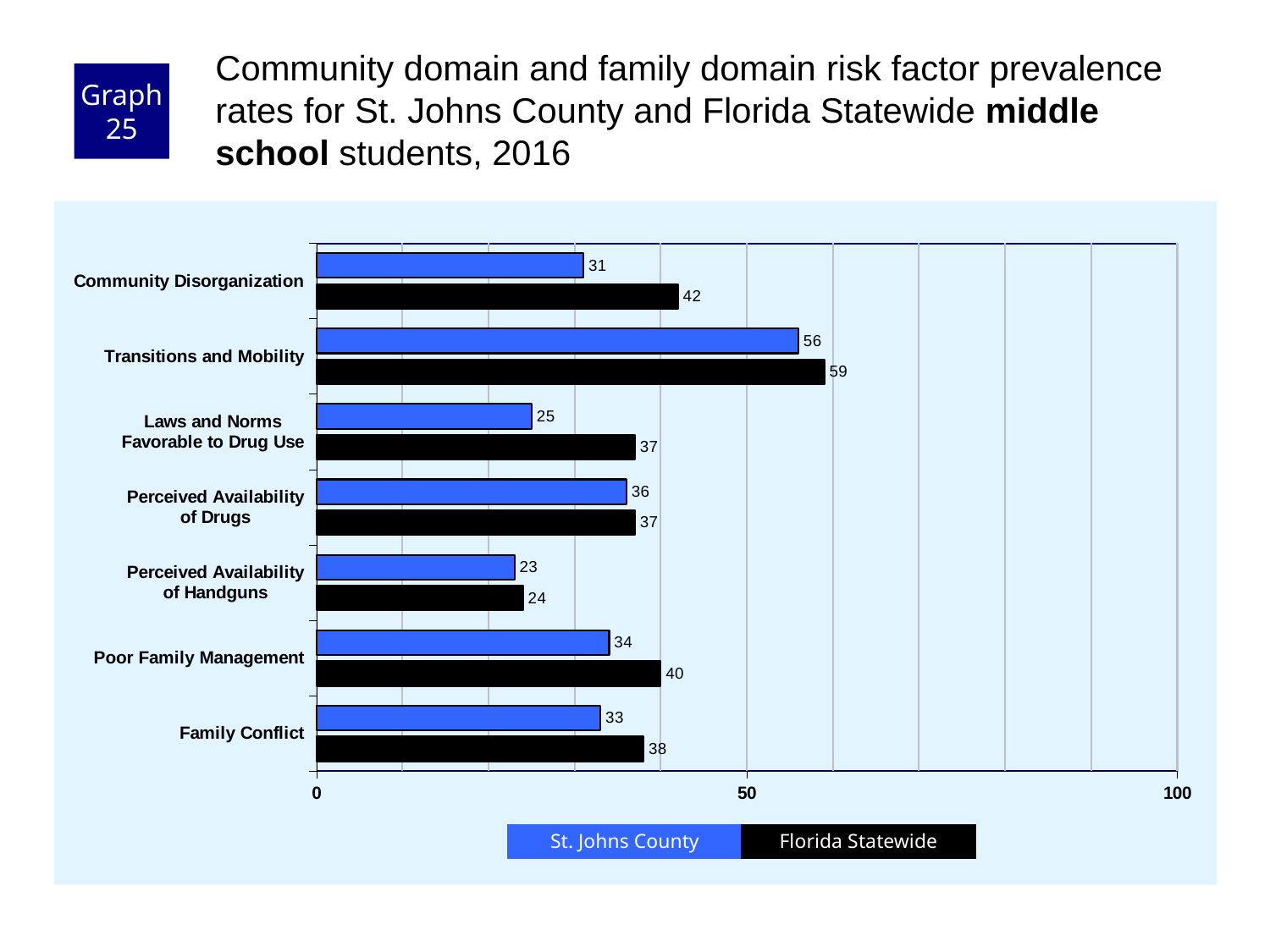
Which risk factor has the highest Florida Statewide value? Transitions and Mobility What is the St. Johns County value for Transitions and Mobility? 56 For Community Disorganization, which is larger: the St. Johns County value or the Florida Statewide value? Florida Statewide Which risk factor has the lowest St. Johns County value? Perceived Availability of Handguns What kind of chart is shown on the slide? bar chart What is the Florida Statewide value for Poor Family Management? 40 What is the difference between the Florida Statewide and St. Johns County values for Laws and Norms Favorable to Drug Use? 12 Is the Florida Statewide value for Transitions and Mobility greater or less than 50? greater How many series does the legend list? 2 What is the St. Johns County value for Perceived Availability of Handguns? 23 How many risk factor categories are shown on the chart? 7 Which colour represents Florida Statewide in the chart? black